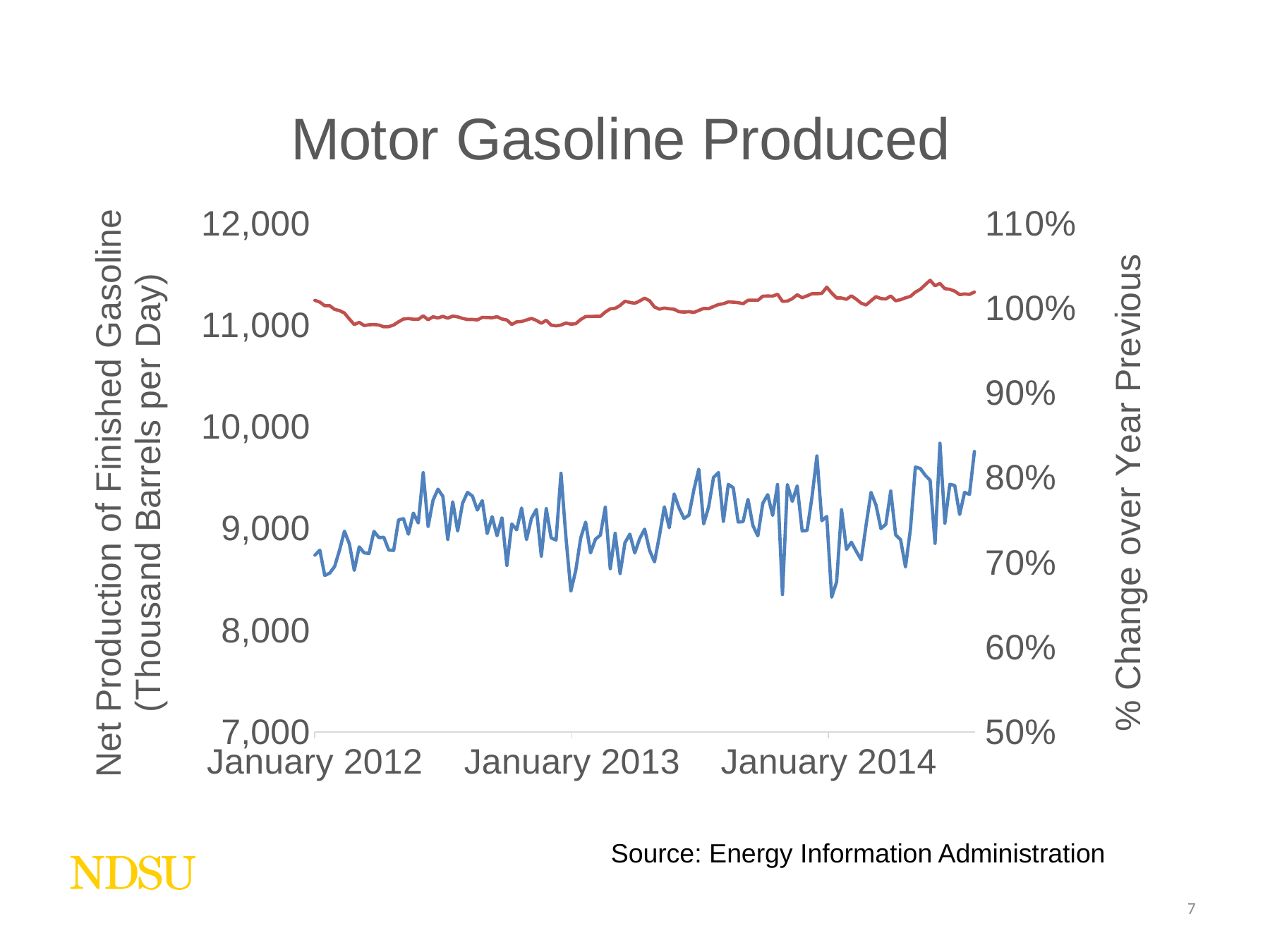
What is the label of the left vertical axis? Net Production of Finished Gasoline (Thousand Barrels per Day) How many lines are plotted on the chart? 2 Is the blue line (net production) greater or less than 8,000 thousand barrels per day throughout the period shown? greater How many labelled dates appear on the horizontal axis? 3 Is the blue line (net production) ever greater or less than 10,000 thousand barrels per day? less What kind of chart is shown on the slide? line chart What is the highest value shown on the right vertical axis? 110% Is the red line (% change over year previous) greater or less than 110% throughout the period shown? less Which line is plotted higher on the chart, the red line or the blue line? the red line Does the red line (% change over year previous) generally rise or fall from January 2012 to the end of the period? rise What is the title of the chart? Motor Gasoline Produced